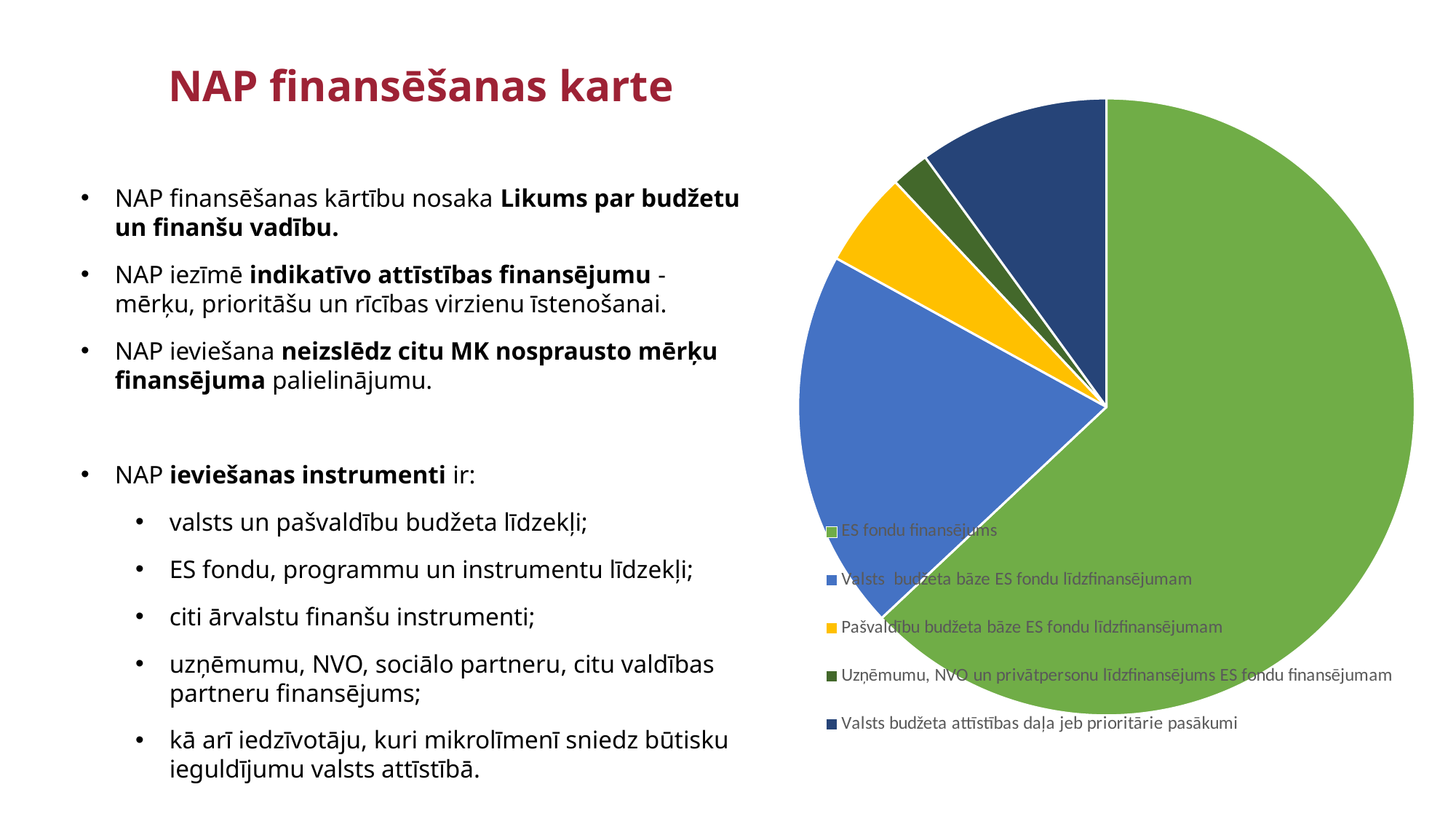
Which category has the largest slice of the pie chart? ES fondu finansējums Which category is shown in yellow in the pie chart? Pašvaldību budžeta bāze ES fondu līdzfinansējumam Which slice is larger: Valsts budžeta attīstības daļa jeb prioritārie pasākumi or Pašvaldību budžeta bāze ES fondu līdzfinansējumam? Valsts budžeta attīstības daļa jeb prioritārie pasākumi Which category has the smallest slice of the pie chart? Uzņēmumu, NVO un privātpersonu līdzfinansējums ES fondu finansējumam Which slice is larger: Valsts budžeta bāze ES fondu līdzfinansējumam or Uzņēmumu, NVO un privātpersonu līdzfinansējums ES fondu finansējumam? Valsts budžeta bāze ES fondu līdzfinansējumam Which slice is larger: Valsts budžeta bāze ES fondu līdzfinansējumam or Pašvaldību budžeta bāze ES fondu līdzfinansējumam? Valsts budžeta bāze ES fondu līdzfinansējumam What colour is the slice for ES fondu finansējums in the pie chart? green What kind of chart is shown on the slide? pie chart How many entries does the legend of the pie chart list? 5 How many slices does the pie chart have? 5